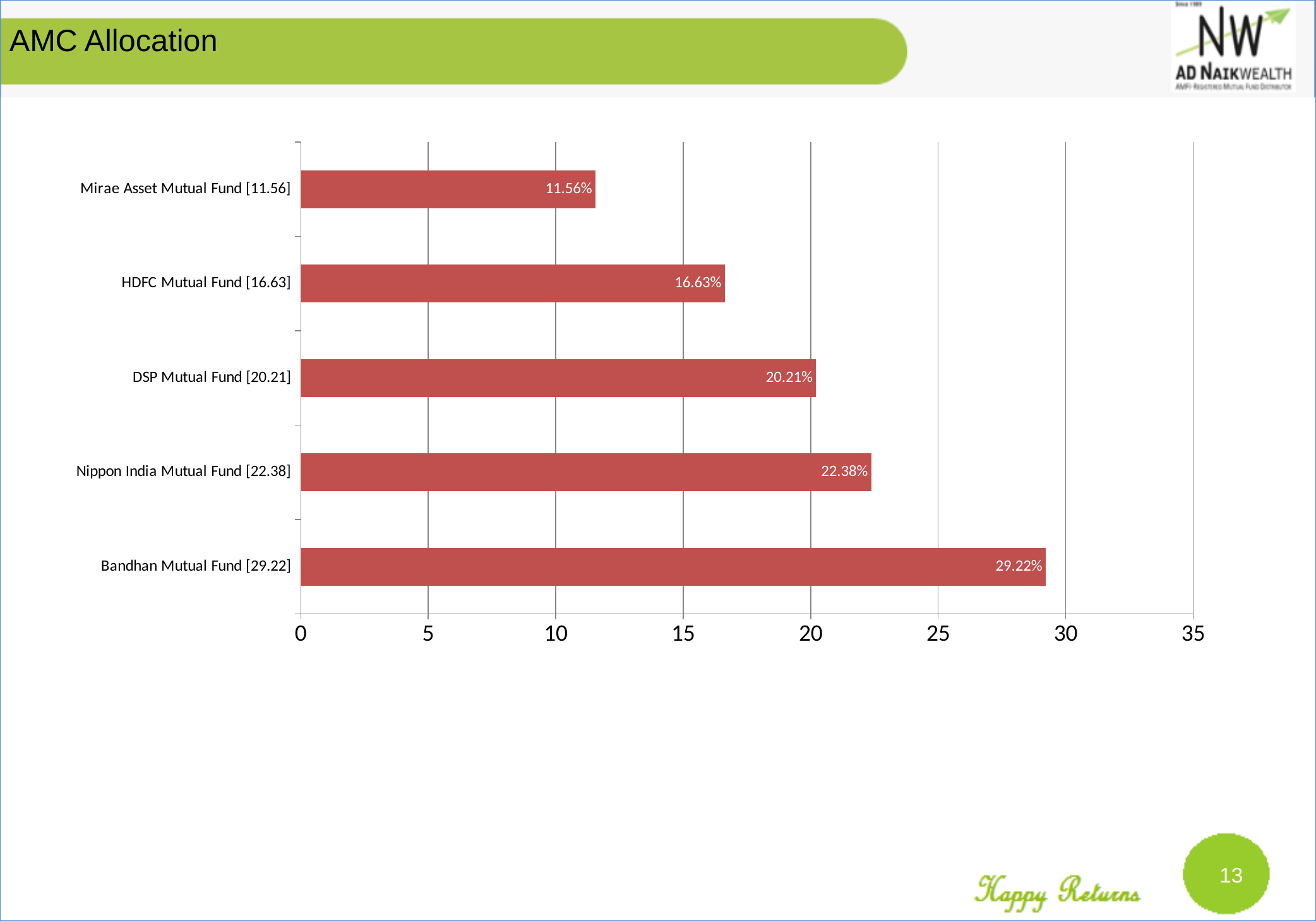
Which is larger, the value for DSP Mutual Fund or HDFC Mutual Fund? DSP Mutual Fund What is the difference between the values for Nippon India Mutual Fund and DSP Mutual Fund? 2.17% Is the value for Nippon India Mutual Fund greater or less than 20? greater What is the title of the slide? AMC Allocation What kind of chart is shown on the slide? Bar chart Which fund has the highest allocation? Bandhan Mutual Fund What is the value for Mirae Asset Mutual Fund? 11.56% What is the value for Bandhan Mutual Fund? 29.22% What is the value for HDFC Mutual Fund? 16.63% What is the difference between the values for Bandhan Mutual Fund and Mirae Asset Mutual Fund? 17.66% How many funds are shown in the chart? 5 Which fund has the lowest allocation? Mirae Asset Mutual Fund